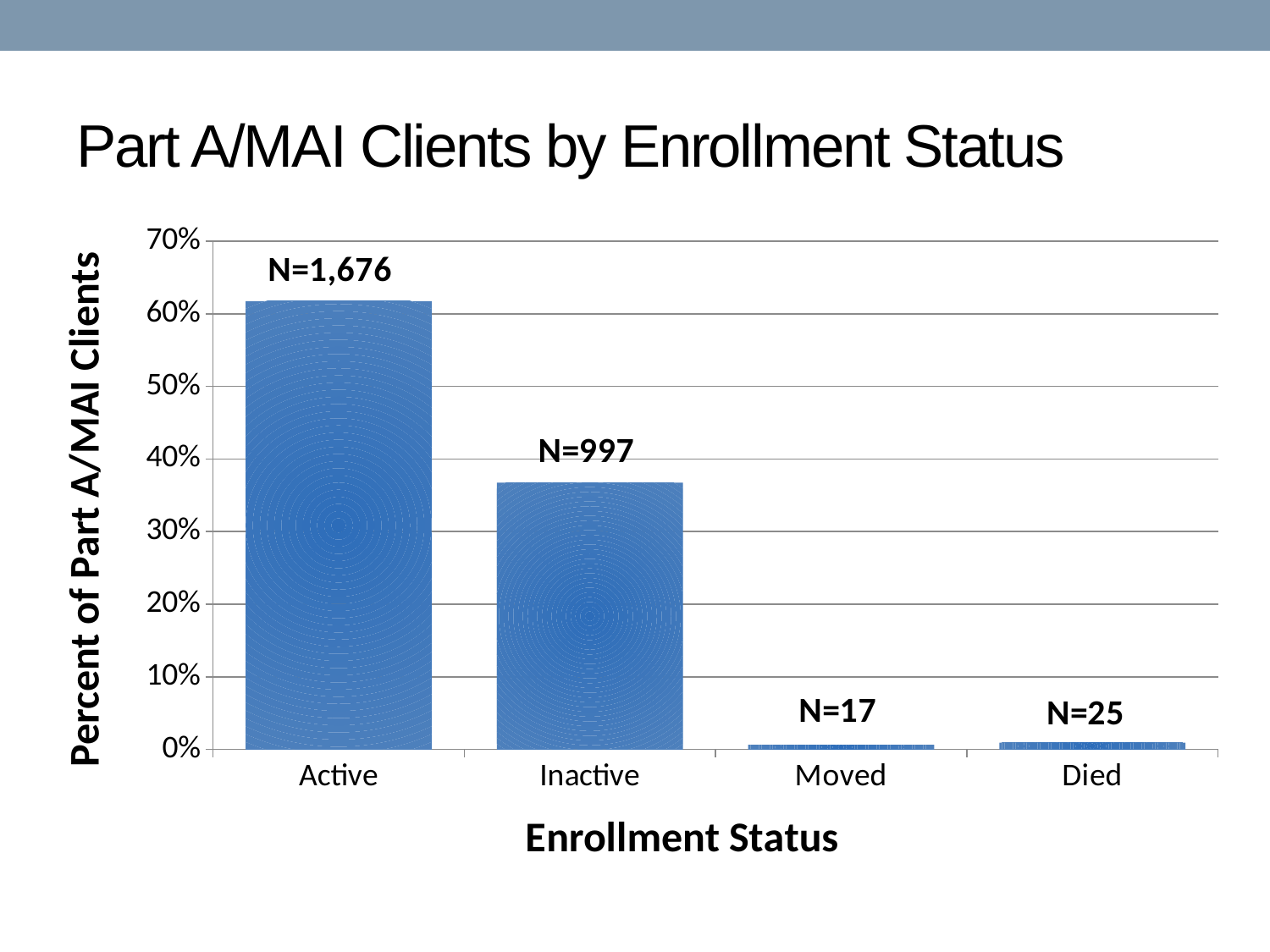
Which enrollment status has the highest percent of Part A/MAI clients? Active Is the percent of clients for Inactive greater or less than 40%? less What is the N label shown above the Active bar? N=1,676 What is the label of the y axis? Percent of Part A/MAI Clients What is the N label shown above the Moved bar? N=17 How many enrollment status categories are shown on the x axis? 4 Which enrollment status has the lowest percent of Part A/MAI clients? Moved What kind of chart is shown on the slide? bar chart Which has a larger percent of Part A/MAI clients, Active or Inactive? Active What is the N label shown above the Died bar? N=25 Is the percent of clients for Active greater or less than 60%? greater What is the N label shown above the Inactive bar? N=997